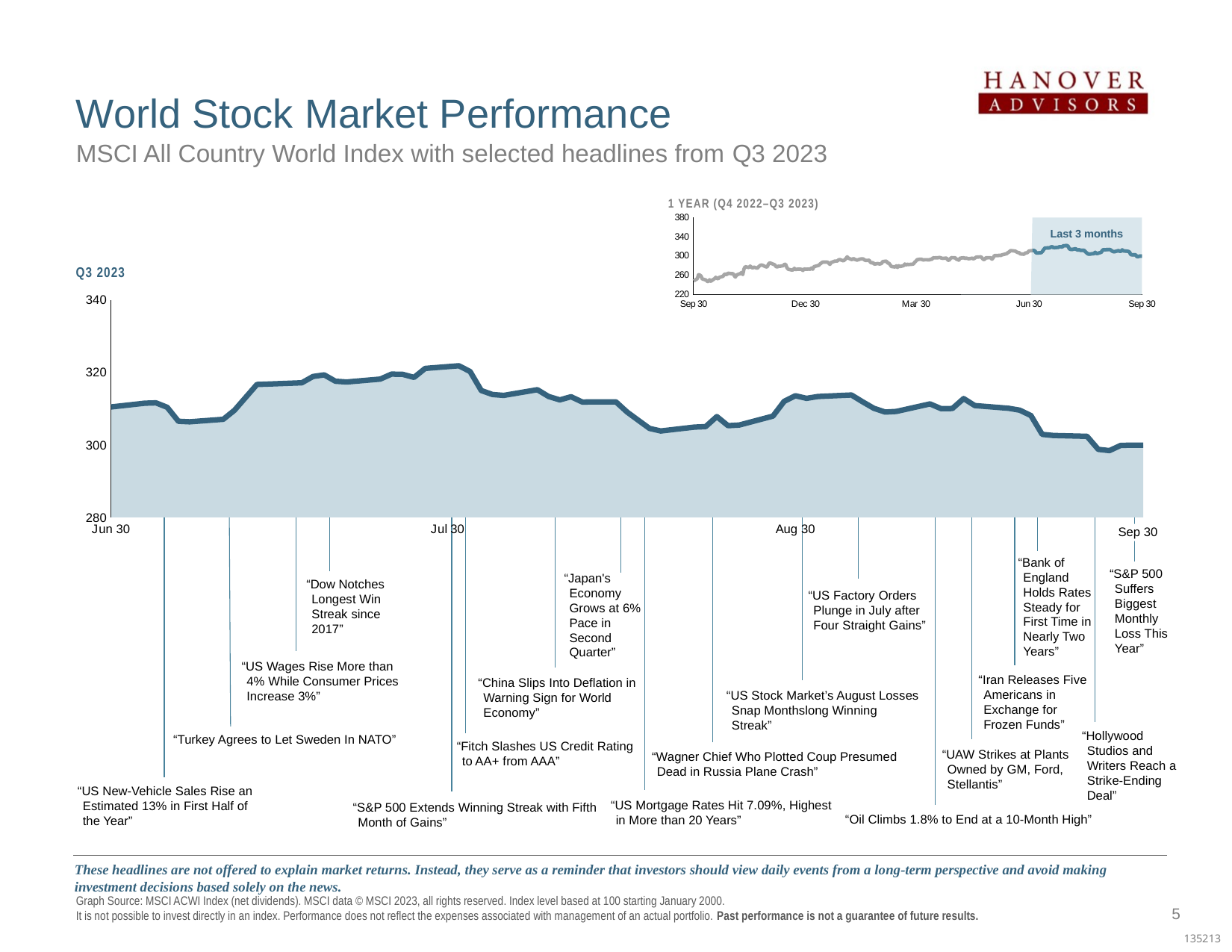
On the Q3 2023 chart, does the index end the quarter (Sep 30) higher or lower than it started (Jun 30)? lower On the 1 YEAR inset chart, does the index generally rise or fall from the first Sep 30 to the last Sep 30? rise On the Q3 2023 chart, is the index value at Aug 30 greater or less than 300? greater How many date labels are shown on the x axis of the 1 YEAR inset chart? 5 On the 1 YEAR inset chart, is the index value at Jun 30 greater or less than 300? greater What is the title of the small inset chart in the upper right? 1 YEAR (Q4 2022–Q3 2023) On the Q3 2023 chart, is the index value at Sep 30 greater or less than 320? less What kind of chart is the Q3 2023 chart on the left? area chart On the Q3 2023 chart, what is the highest value shown on the vertical axis? 340 How many date labels are shown on the x axis of the Q3 2023 chart? 4